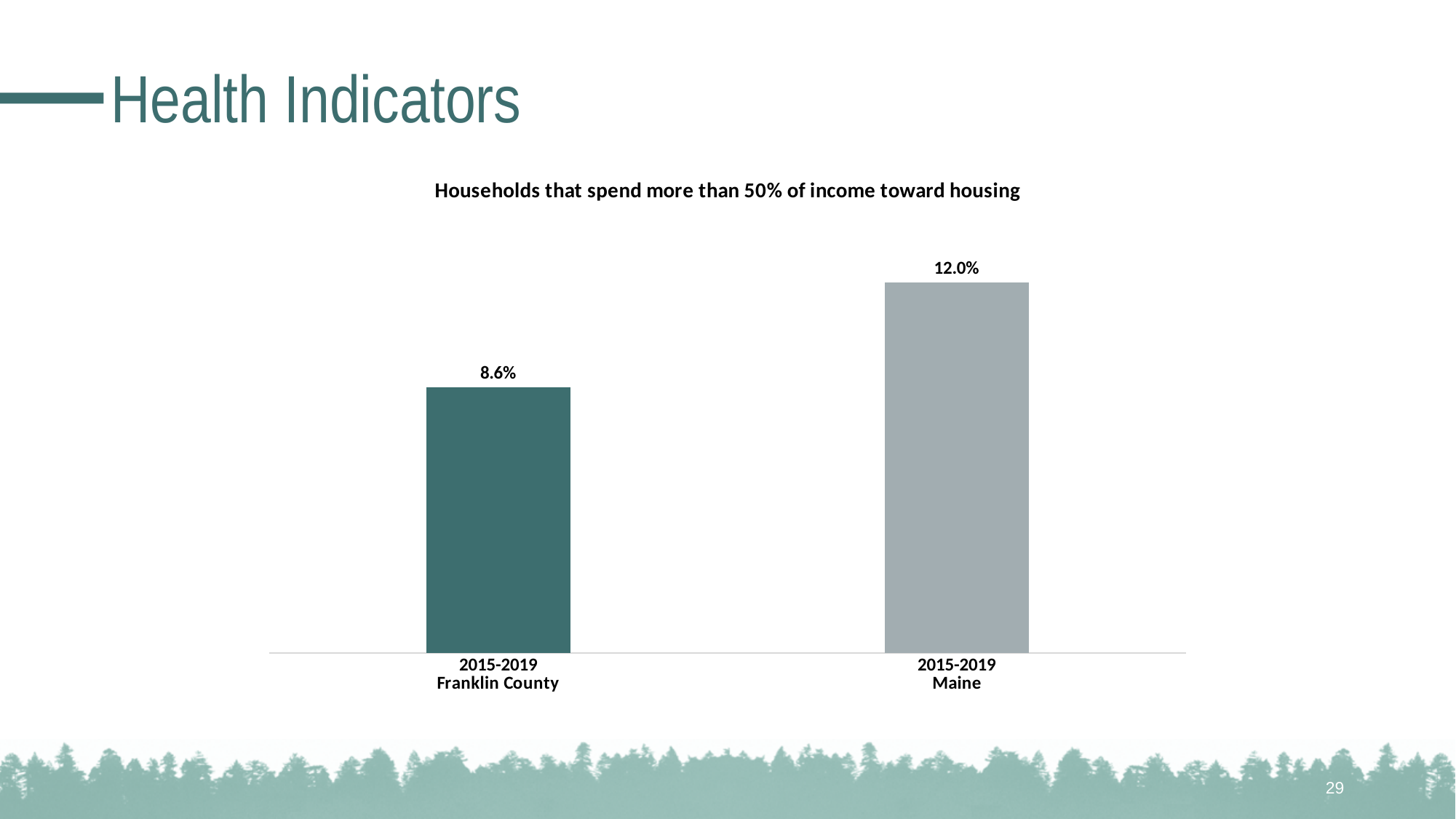
How many bars are shown in the chart? 2 What is the value for Maine (2015-2019)? 12.0% Which category has the lowest value? Franklin County Which is larger, the value for Franklin County or the value for Maine? Maine What is the difference between the Maine value and the Franklin County value? 3.4% What kind of chart is shown on the slide? Bar chart Which category has the highest value? Maine What is the title of the chart? Households that spend more than 50% of income toward housing What is the value for Franklin County (2015-2019)? 8.6% What time period is shown for both bars in the chart? 2015-2019